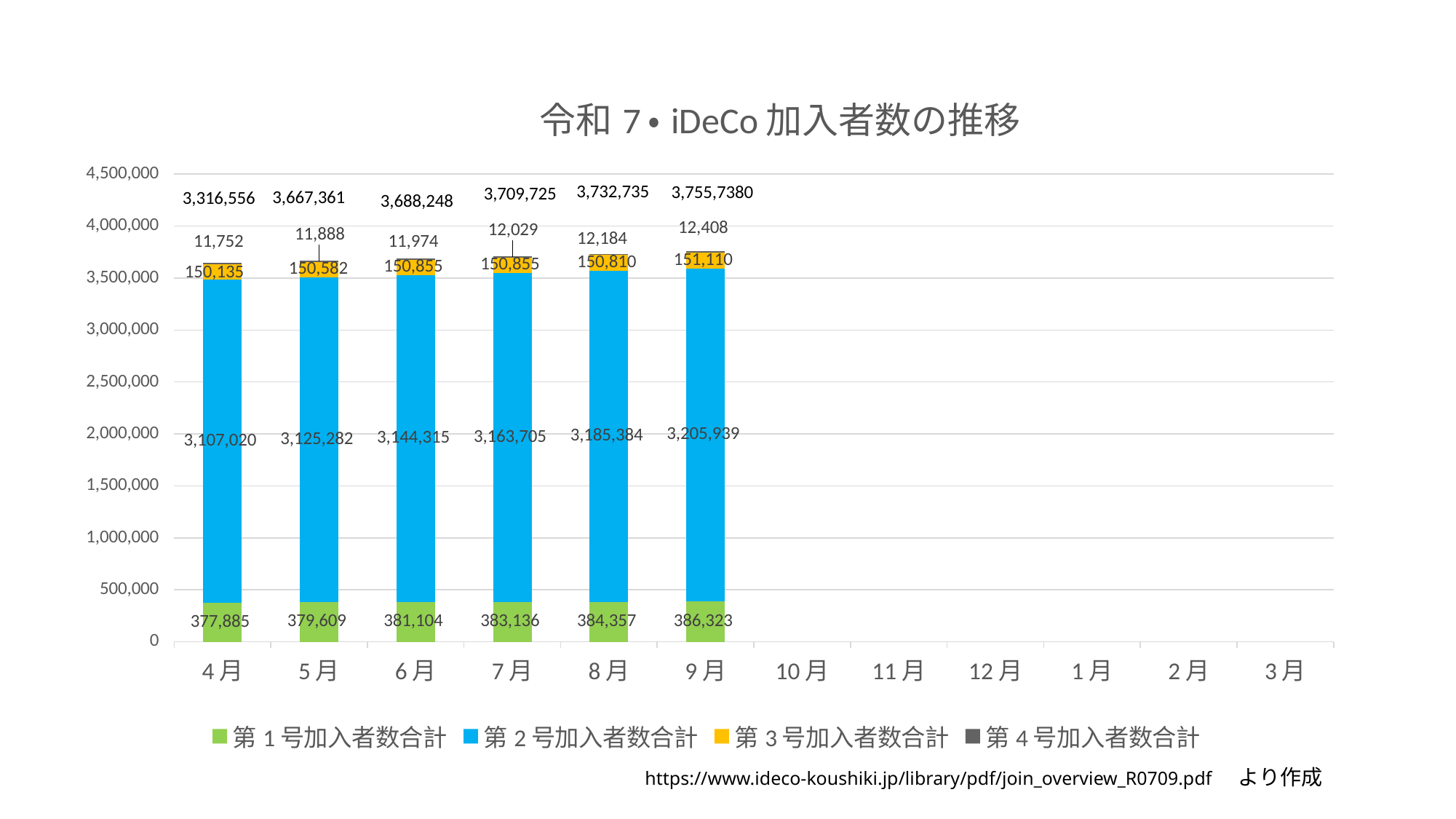
What is the value of 第２号加入者数合計 for 9月? 3,205,939 Which month has the highest value for 第２号加入者数合計? 9月 Do the 第２号加入者数合計 values rise or fall from 4月 to 9月? Rise What is the total of the stacked bar for 6月? 3,688,248 Which is larger, the 第４号加入者数合計 value for 5月 or for 6月? 6月 How many series does the legend list? 4 What is the value of 第１号加入者数合計 for 4月? 377,885 What is the value of 第３号加入者数合計 for 7月? 150,855 What is the value of 第４号加入者数合計 for 8月? 12,184 What kind of chart is shown on the slide? Stacked bar chart What is the difference between the 第１号加入者数合計 values for 9月 and 4月? 8,438 Which month has the lowest value for 第１号加入者数合計? 4月